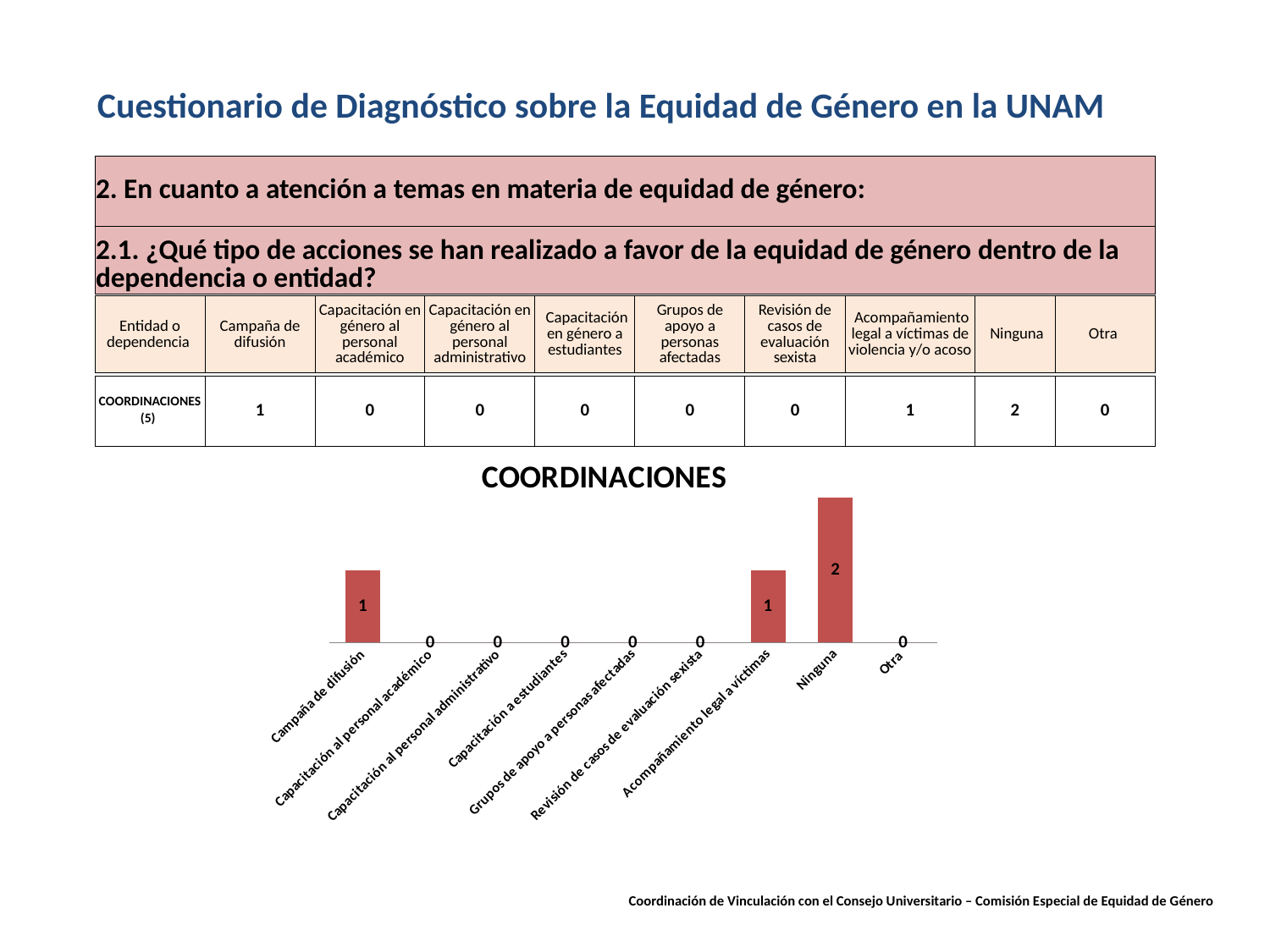
What kind of chart is the COORDINACIONES chart? bar chart What is the value for Acompañamiento legal a víctimas in the COORDINACIONES chart? 1 How many categories in the COORDINACIONES chart have a value of 0? 6 What is the value for Campaña de difusión in the COORDINACIONES chart? 1 What is the value for Capacitación a estudiantes in the COORDINACIONES chart? 0 What is the difference between the values for Ninguna and Campaña de difusión in the COORDINACIONES chart? 1 What is the title of the chart on the slide? COORDINACIONES What colour are the bars in the COORDINACIONES chart? red Which is larger in the COORDINACIONES chart, the value for Ninguna or the value for Otra? Ninguna Which category has the highest value in the COORDINACIONES chart? Ninguna What is the value for Ninguna in the COORDINACIONES chart? 2 How many categories are shown on the x axis of the COORDINACIONES chart? 9